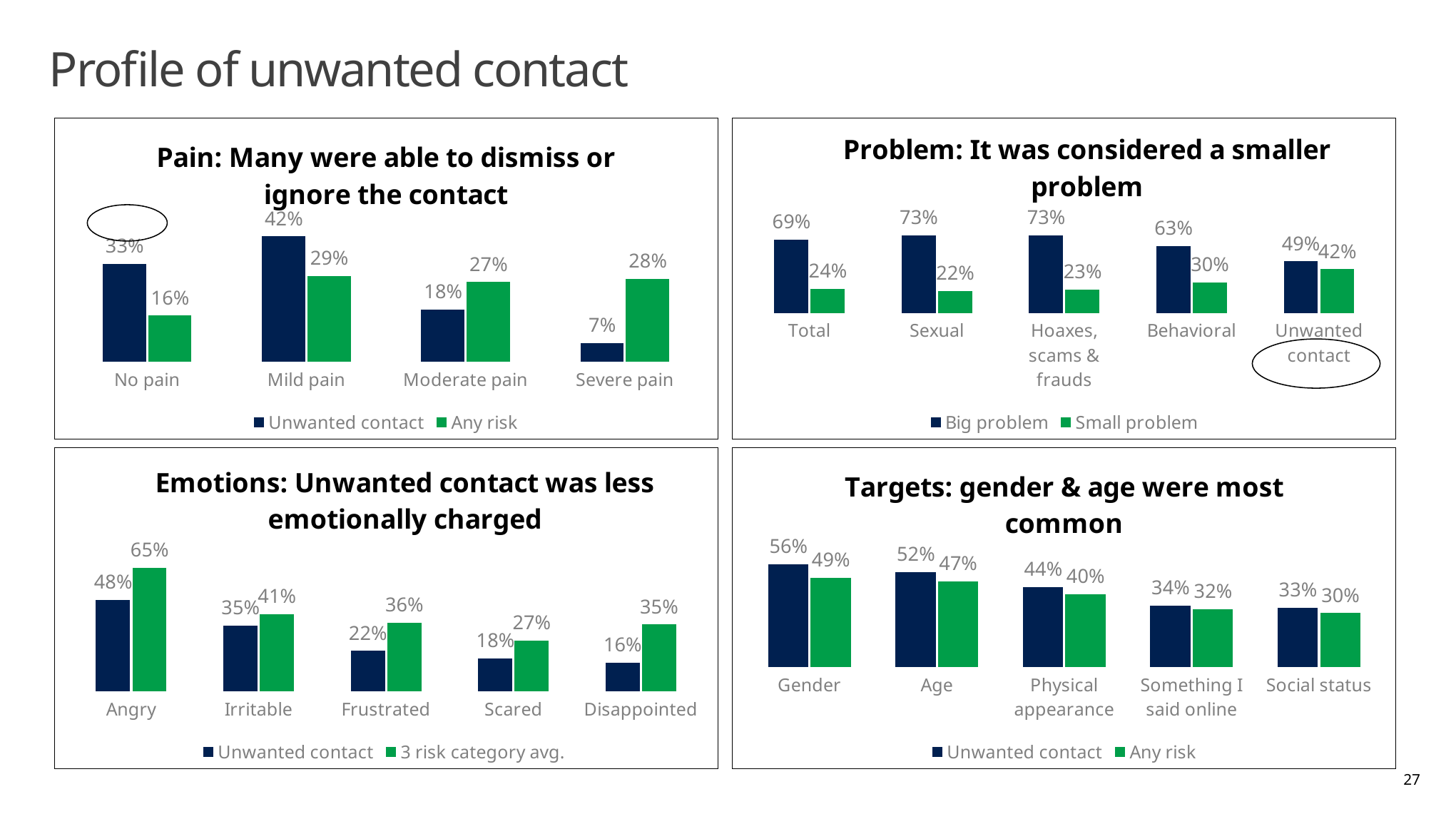
In the 'Emotions' chart, what is the 3 risk category avg. value for Angry? 65% What type of chart is the 'Targets' chart? Bar chart In the 'Targets' chart, how many series does the legend list? 2 In the 'Problem' chart, what is the Small problem value for Unwanted contact? 42% In the 'Pain' chart, what is the difference between the Unwanted contact and Any risk values for No pain? 17% In the 'Targets' chart, what is the Unwanted contact value for Gender? 56% In the 'Emotions' chart, what is the difference between the 3 risk category avg. and Unwanted contact values for Frustrated? 14% In the 'Pain' chart, which pain category has the lowest Unwanted contact value? Severe pain In the 'Problem' chart, how many categories are shown on the x axis? 5 In the 'Problem' chart, which category has the lowest Big problem value? Unwanted contact In the 'Pain' chart, what is the Unwanted contact value for Mild pain? 42% In the 'Emotions' chart, which is larger for Disappointed: Unwanted contact or 3 risk category avg.? 3 risk category avg.